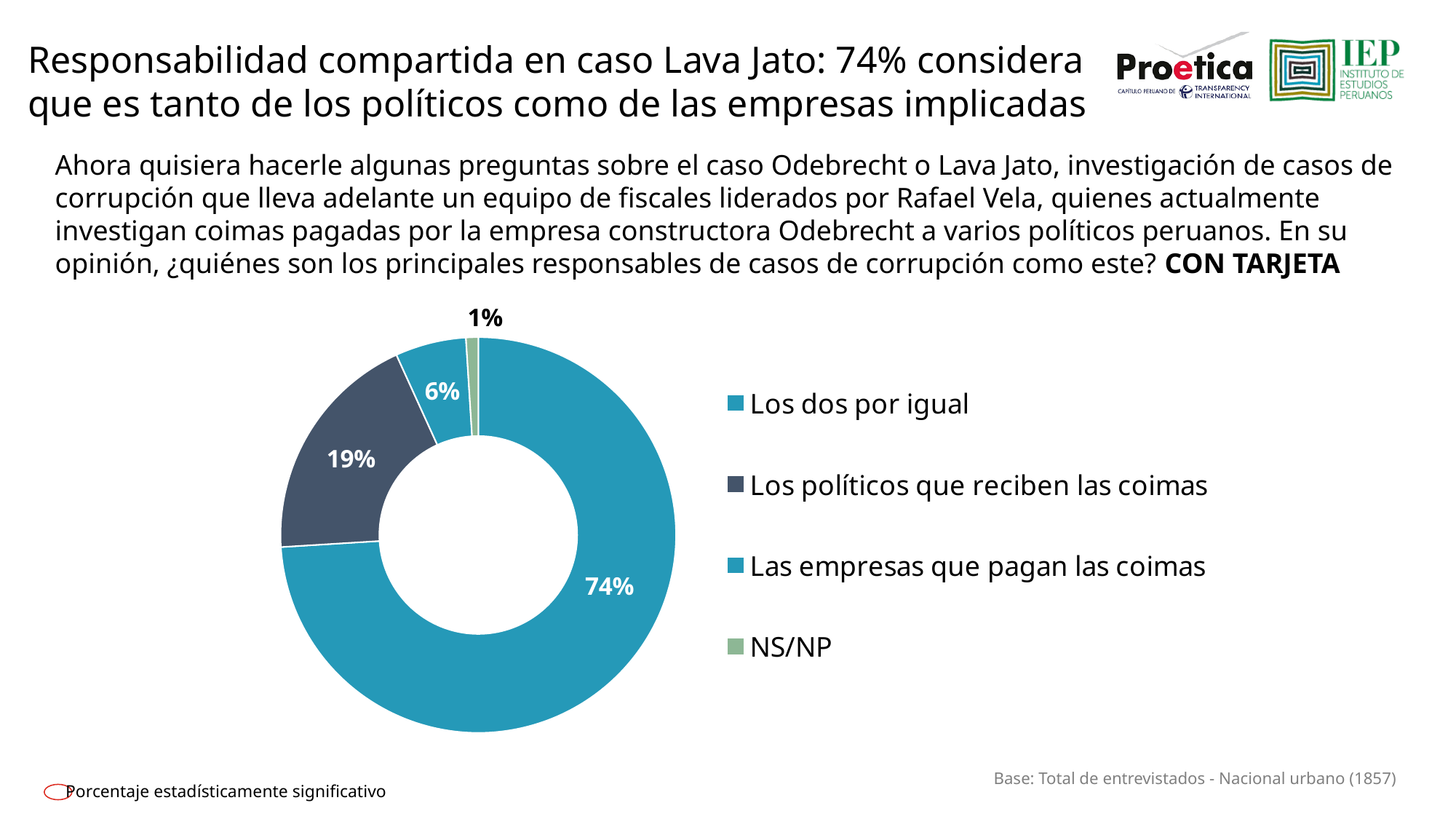
What percentage of respondents answered "NS/NP"? 1% What percentage of respondents answered "Los dos por igual"? 74% Which response category has the smallest share of the chart? NS/NP How many response categories are shown in the chart? 4 What percentage of respondents answered "Los políticos que reciben las coimas"? 19% What kind of chart is shown on the slide? Donut (pie) chart What percentage of respondents answered "Las empresas que pagan las coimas"? 6% Which response category has the largest share of the chart? Los dos por igual What is the difference in percentage points between "Los dos por igual" and "Los políticos que reciben las coimas"? 55 What colour is the slice for "Los políticos que reciben las coimas"? Dark blue-grey Which is larger: the share for "Los políticos que reciben las coimas" or the share for "Las empresas que pagan las coimas"? Los políticos que reciben las coimas What is the difference in percentage points between "Los políticos que reciben las coimas" and "Las empresas que pagan las coimas"? 13